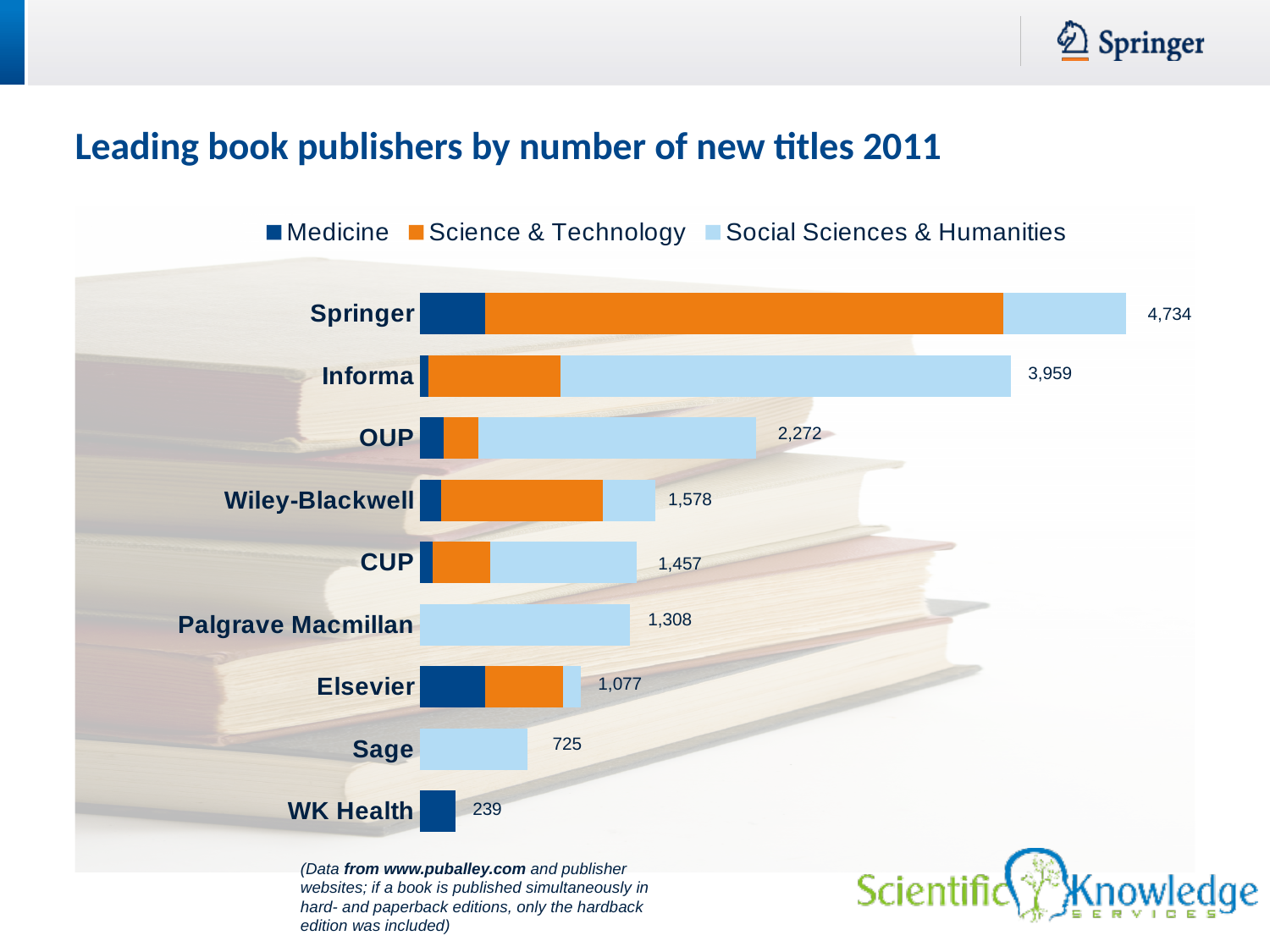
What is the difference between the totals for OUP and Wiley-Blackwell? 694 What is the total number of new titles shown for Palgrave Macmillan? 1,308 How many publishers are shown in the chart? 9 How many series does the legend list? 3 Which has a larger total of new titles, CUP or Elsevier? CUP What is the total number of new titles shown for WK Health? 239 Which publisher has the highest total number of new titles? Springer What type of chart is shown on the slide? Stacked bar chart What is the total number of new titles shown for Informa? 3,959 What is the difference between the totals for Springer and Informa? 775 What is the total number of new titles shown for Springer? 4,734 Which publisher has the lowest total number of new titles? WK Health